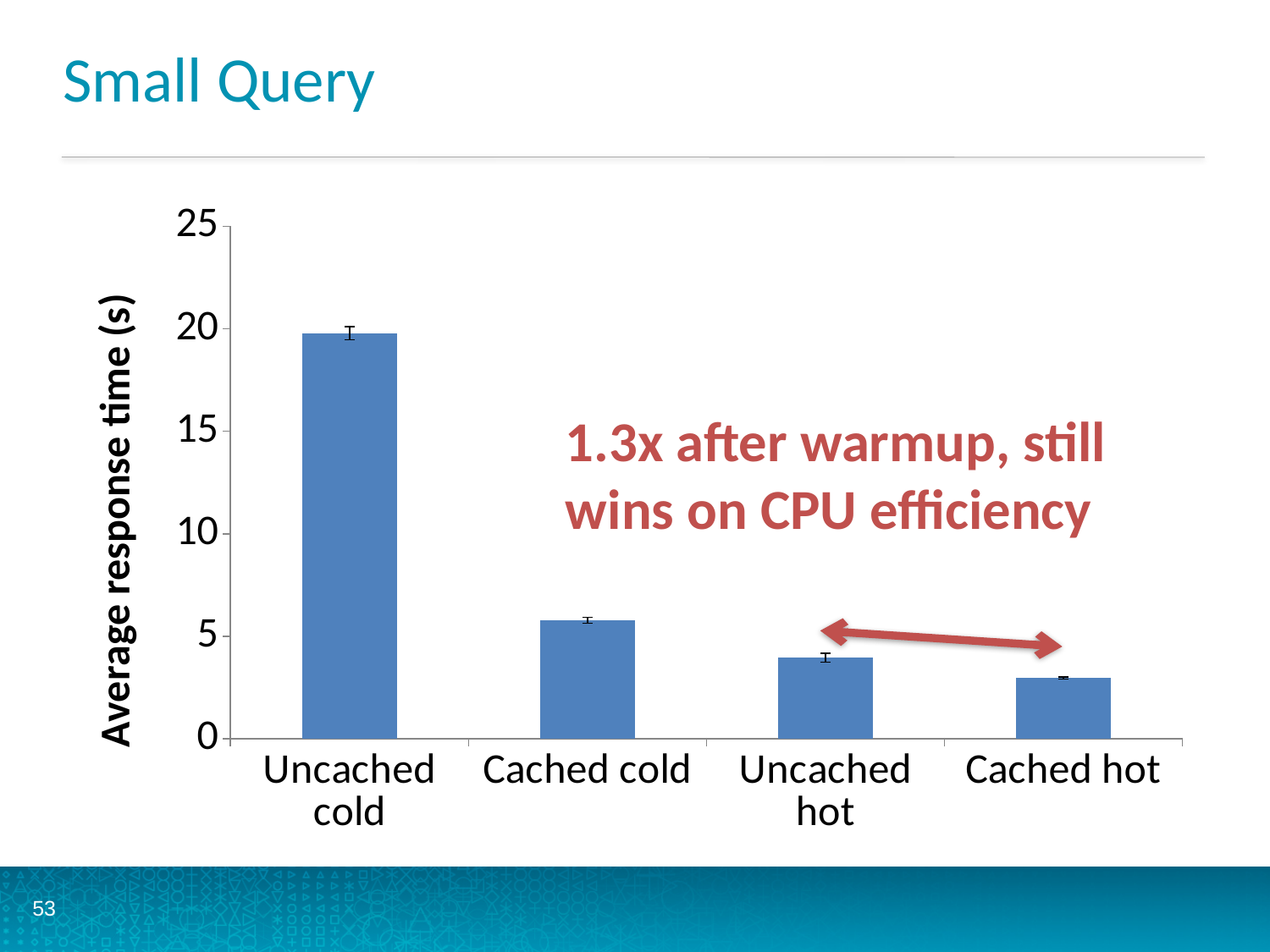
Is the value for Uncached cold greater or less than 15? greater How many categories are plotted on the x axis? 4 Is the value for Cached hot greater or less than 5? less Which is larger, the value for Uncached hot or the value for Cached hot? Uncached hot Is the value for Uncached hot greater or less than 5? less What kind of chart is shown on the slide? bar chart Do the bar values rise or fall from left to right along the x axis? fall What is the title of the y axis? Average response time (s) Which is larger, the value for Cached cold or the value for Uncached hot? Cached cold Which category has the lowest average response time? Cached hot Which category has the highest average response time? Uncached cold